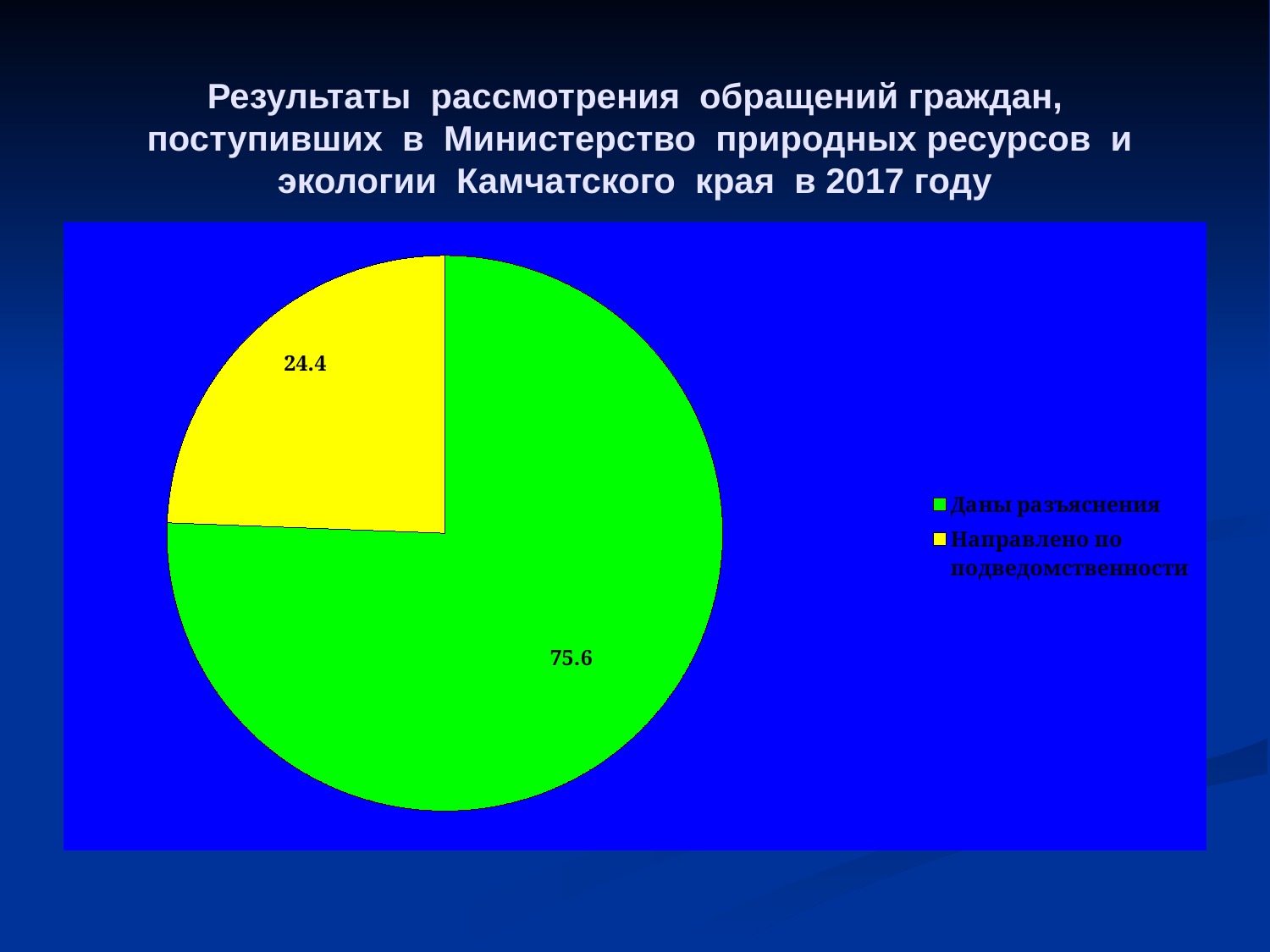
What is the total of the two slice values? 100 Which category has the largest slice? Даны разъяснения What kind of chart is shown on the slide? pie chart What is the value for "Направлено по подведомственности"? 24.4 How many entries does the legend list? 2 Which category has the smallest slice? Направлено по подведомственности How many slices does the pie chart have? 2 What is the difference between the values for "Даны разъяснения" and "Направлено по подведомственности"? 51.2 Which is larger: "Даны разъяснения" or "Направлено по подведомственности"? Даны разъяснения What colour is the slice for "Направлено по подведомственности"? yellow What colour is the slice for "Даны разъяснения"? green What is the value for "Даны разъяснения"? 75.6